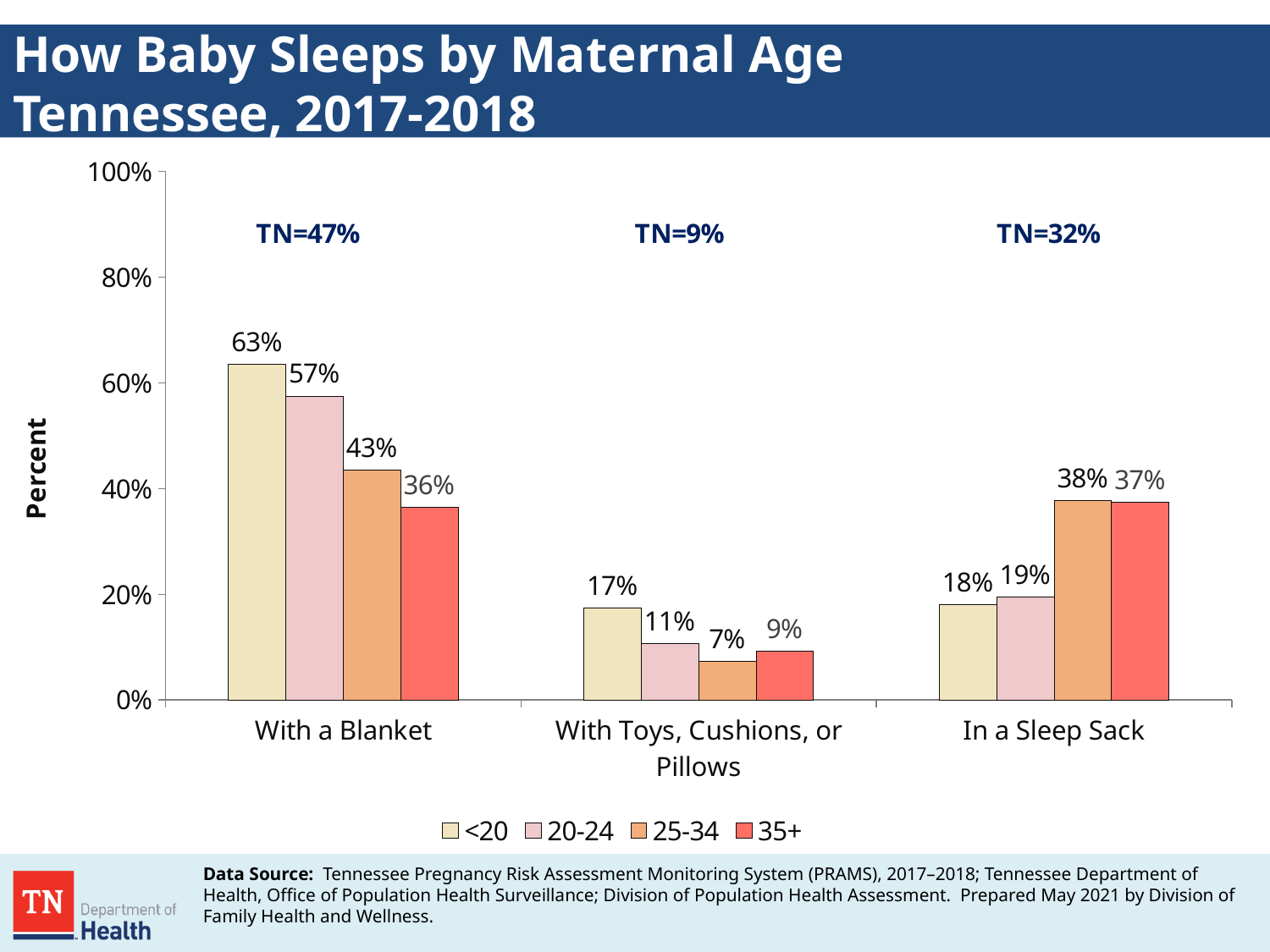
What is the overall Tennessee value shown above the 'In a Sleep Sack' category? TN=32% What is the difference between the <20 and 35+ values for 'With a Blanket'? 27% What percentage of mothers under 20 reported their baby sleeps with a blanket? 63% Which is larger for 'In a Sleep Sack': the value for <20 or the value for 25-34? 25-34 What is the value for the 35+ age group in the 'With Toys, Cushions, or Pillows' category? 9% What type of chart is shown on the slide? Bar chart What is the value for the 25-34 age group in the 'In a Sleep Sack' category? 38% How many sleep categories are shown on the x axis? 3 Is the value for the 20-24 group in 'With a Blanket' greater or less than 40%? greater How many maternal age groups does the legend list? 4 Which maternal age group has the highest value for 'With a Blanket'? <20 Which maternal age group has the lowest value for 'With Toys, Cushions, or Pillows'? 25-34